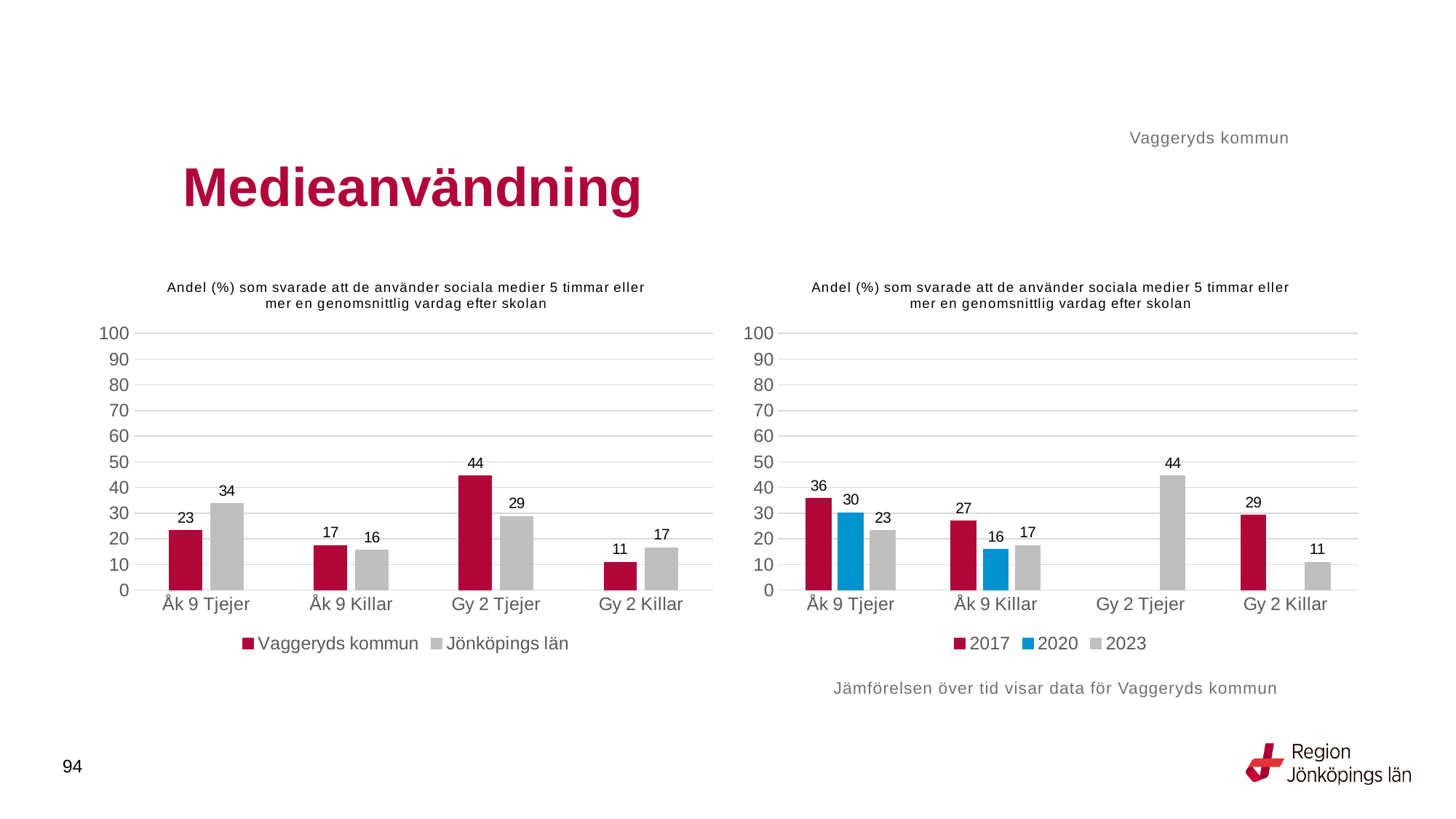
In the left chart, how many series does the legend list? 2 In the right chart, what is the value for 2020 for Åk 9 Tjejer? 30 In the left chart, which is larger for Åk 9 Killar: Vaggeryds kommun or Jönköpings län? Vaggeryds kommun In the left chart, which category has the lowest value for Vaggeryds kommun? Gy 2 Killar What kind of chart is the right chart? Bar chart In the right chart, how many series does the legend list? 3 In the left chart, what is the difference between Vaggeryds kommun and Jönköpings län for Gy 2 Tjejer? 15 In the right chart, what is the value for 2017 for Gy 2 Killar? 29 In the left chart, what is the value for Jönköpings län for Åk 9 Tjejer? 34 In the left chart, what is the value for Vaggeryds kommun for Gy 2 Tjejer? 44 In the right chart, what is the difference between 2017 and 2023 for Åk 9 Tjejer? 13 In the right chart, which category has the highest value for 2023? Gy 2 Tjejer